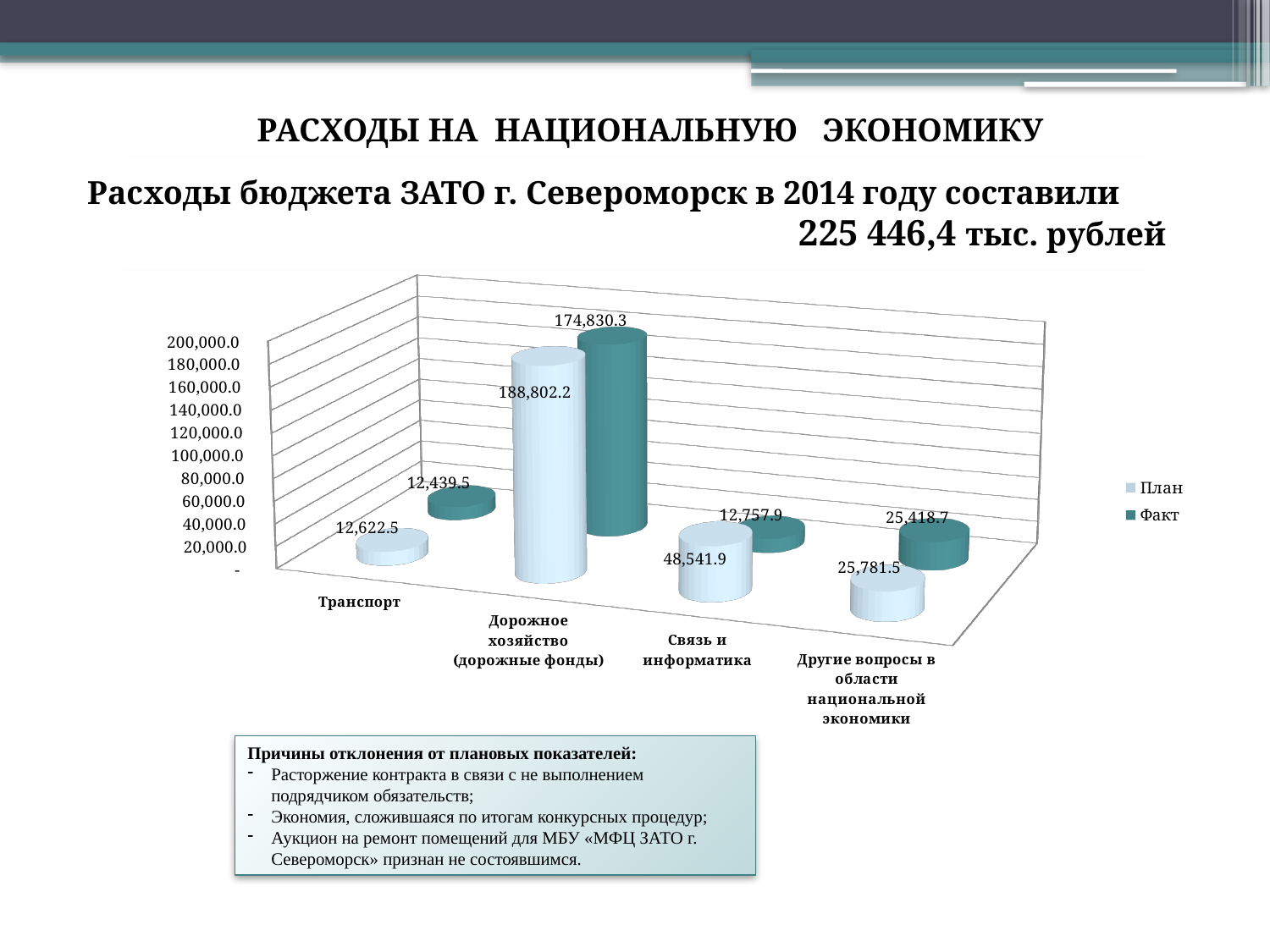
Which category has the lowest План value? Транспорт What is the План value for Другие вопросы в области национальной экономики? 25,781.5 Which is larger for Связь и информатика: the План value or the Факт value? План What type of chart is shown on the slide? Bar chart What is the difference between the План and Факт values for Дорожное хозяйство (дорожные фонды)? 13,971.9 How many categories are shown on the x axis of the chart? 4 What is the Факт (actual) value for Связь и информатика? 12,757.9 What is the difference between the План and Факт values for Связь и информатика? 35,784.0 Which category has the highest Факт value? Дорожное хозяйство (дорожные фонды) What is the План (plan) value for Дорожное хозяйство (дорожные фонды)? 188,802.2 How many series does the chart legend list? 2 What is the Факт value for Транспорт? 12,439.5